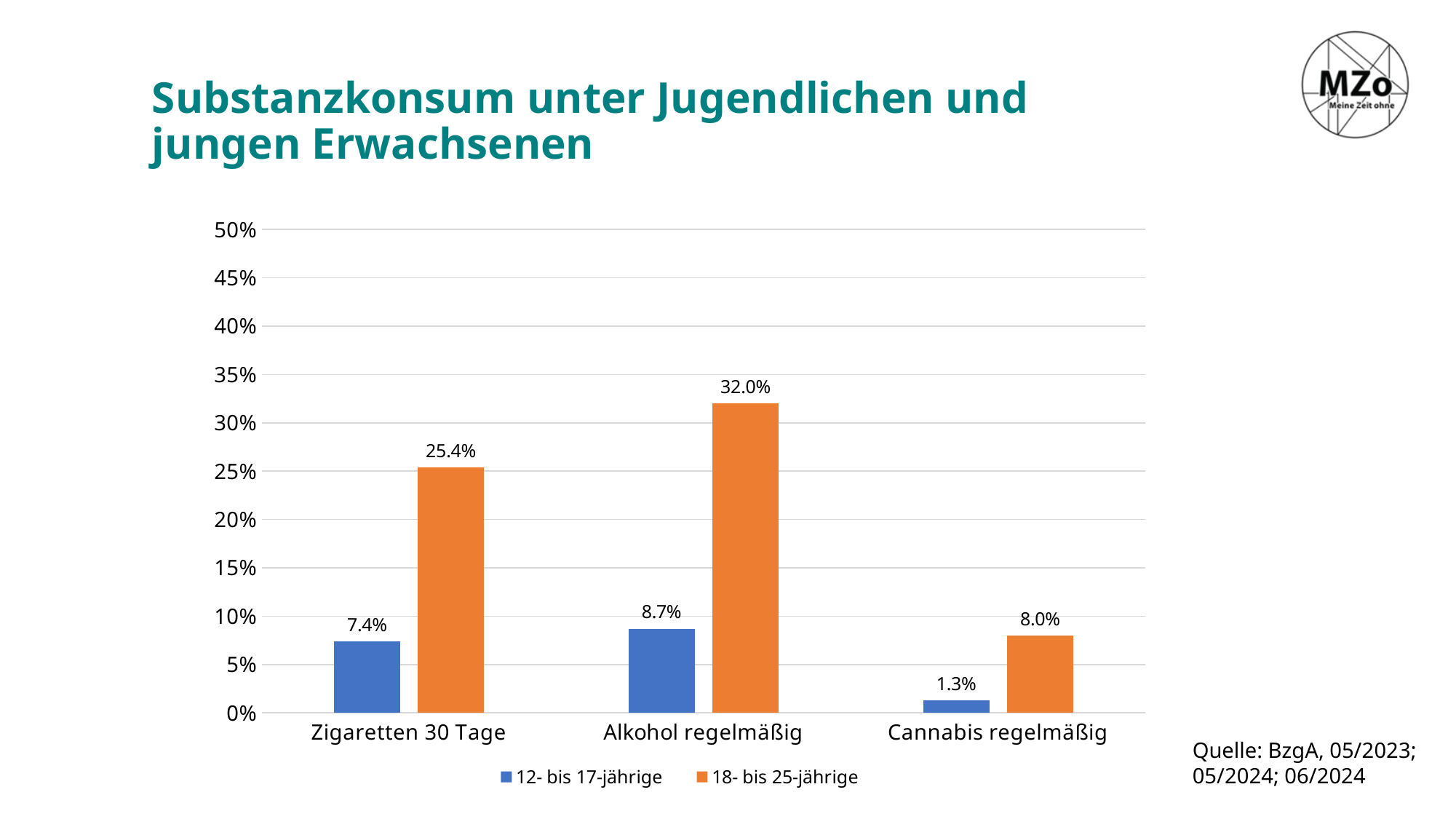
Which category has the highest value for 18- bis 25-jährige? Alkohol regelmäßig What kind of chart is shown on the slide? Bar chart Which is larger for Cannabis regelmäßig: the value for 12- bis 17-jährige or for 18- bis 25-jährige? 18- bis 25-jährige How many categories are shown on the x axis? 3 What is the value for 12- bis 17-jährige for Cannabis regelmäßig? 1.3% What is the difference between the 18- bis 25-jährige and 12- bis 17-jährige values for Zigaretten 30 Tage? 18.0% Which category has the lowest value for 12- bis 17-jährige? Cannabis regelmäßig What colour are the bars for 18- bis 25-jährige? Orange What is the value for 18- bis 25-jährige for Alkohol regelmäßig? 32.0% What is the value for 12- bis 17-jährige for Zigaretten 30 Tage? 7.4% How many series does the legend list? 2 Is the value for 18- bis 25-jährige for Zigaretten 30 Tage greater or less than 20%? greater